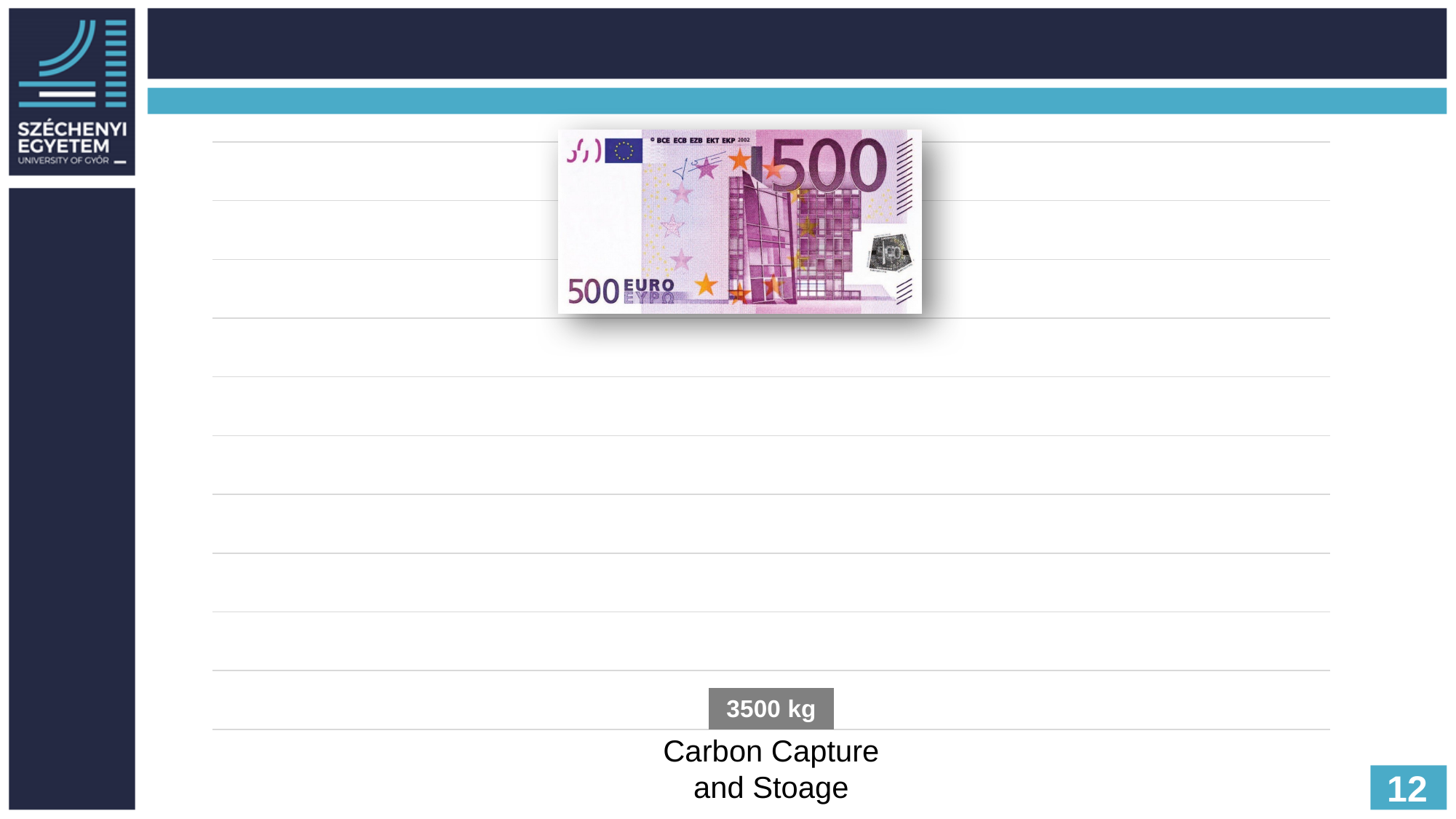
What value is shown for Carbon Capture and Stoage? 3500 kg How many categories are labelled on the x axis of the chart? 1 What image is placed above the chart's gridlines? A 500 euro banknote What category label appears below the chart's data label? Carbon Capture and Stoage